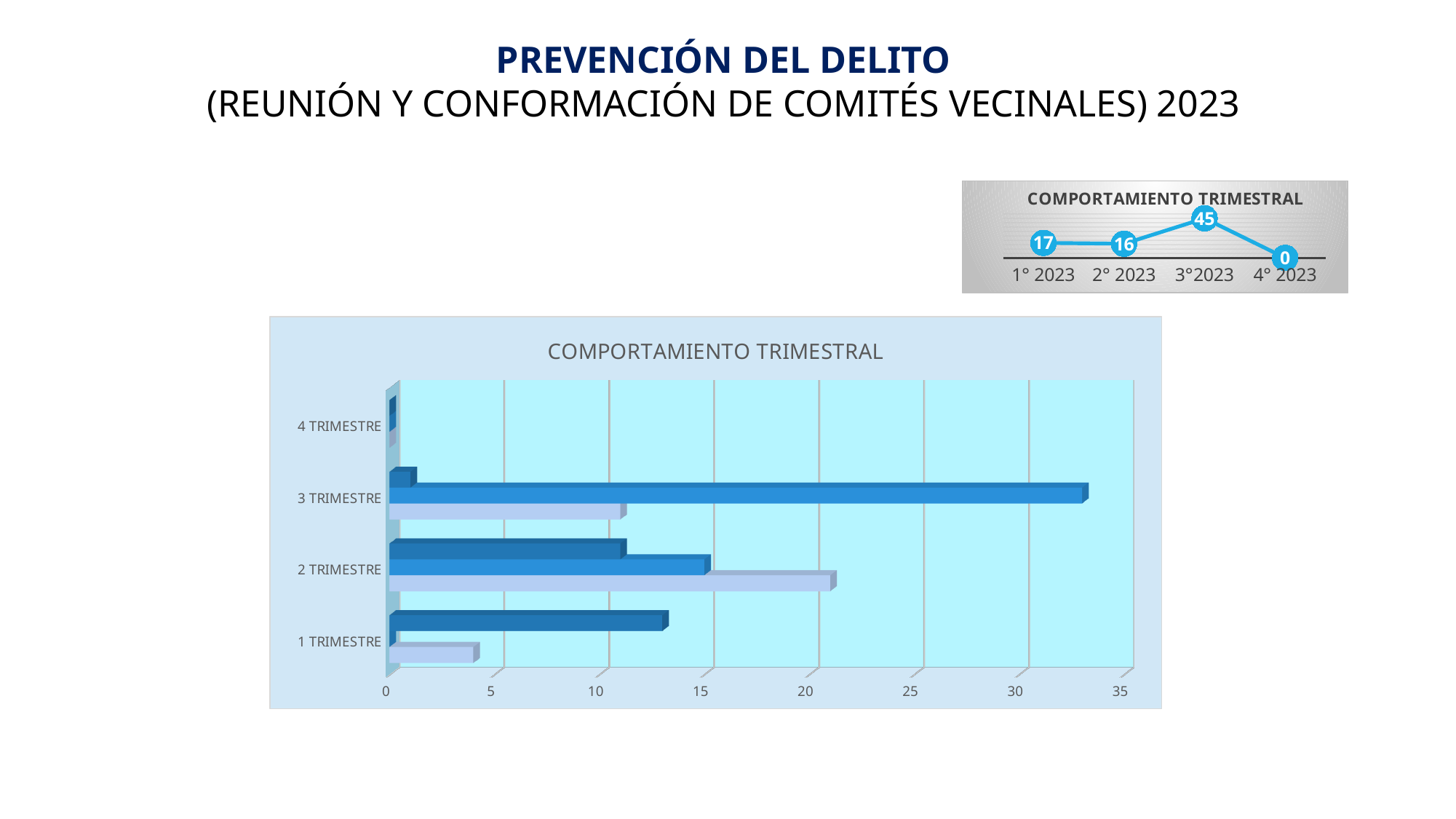
In the large bar chart, is the shortest bar for 1 TRIMESTRE greater or less than 5? less In the line chart at the top right, which quarter has the highest value? 3°2023 In the large bar chart, is the longest bar for 3 TRIMESTRE greater or less than 30? greater In the large bar chart, how many categories are shown on the vertical axis? 4 In the line chart at the top right, what is the value for 4° 2023? 0 What kind of chart is the large chart in the lower part of the slide? Bar chart In the line chart at the top right, what is the difference between the values for 3°2023 and 2° 2023? 29 In the line chart at the top right, what is the value for 1° 2023? 17 In the line chart at the top right, which quarter has the lowest value? 4° 2023 In the line chart at the top right, which is larger, the value for 1° 2023 or 2° 2023? 1° 2023 In the line chart at the top right, what is the value for 3°2023? 45 In the line chart at the top right, how many data points are plotted? 4